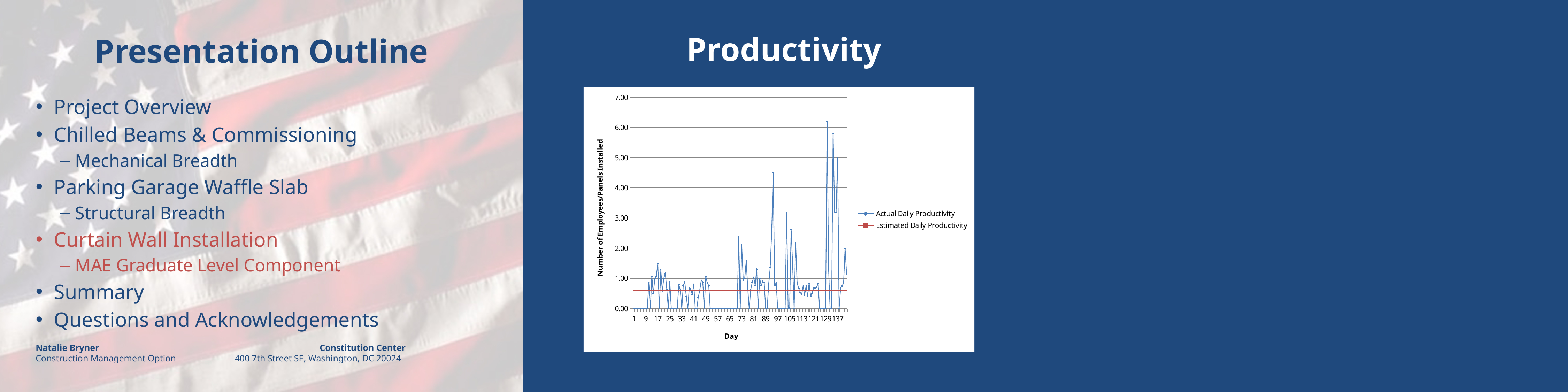
Is the highest value of Actual Daily Productivity greater or less than 5.00? greater How many series does the legend of the Productivity chart list? 2 Is the highest value of Actual Daily Productivity greater or less than 4.00? greater Does the Estimated Daily Productivity line rise, fall, or stay flat across the days? stay flat What kind of chart is shown on the Productivity slide? line chart How many tick labels are shown on the x axis of the Productivity chart? 18 Which series reaches the higher value on the Productivity chart, Actual Daily Productivity or Estimated Daily Productivity? Actual Daily Productivity What is the title of the x axis of the Productivity chart? Day What are the two series named in the legend of the Productivity chart? Actual Daily Productivity and Estimated Daily Productivity At its highest peak, is Actual Daily Productivity larger or smaller than Estimated Daily Productivity? larger Is the Estimated Daily Productivity line greater or less than 1.00? less